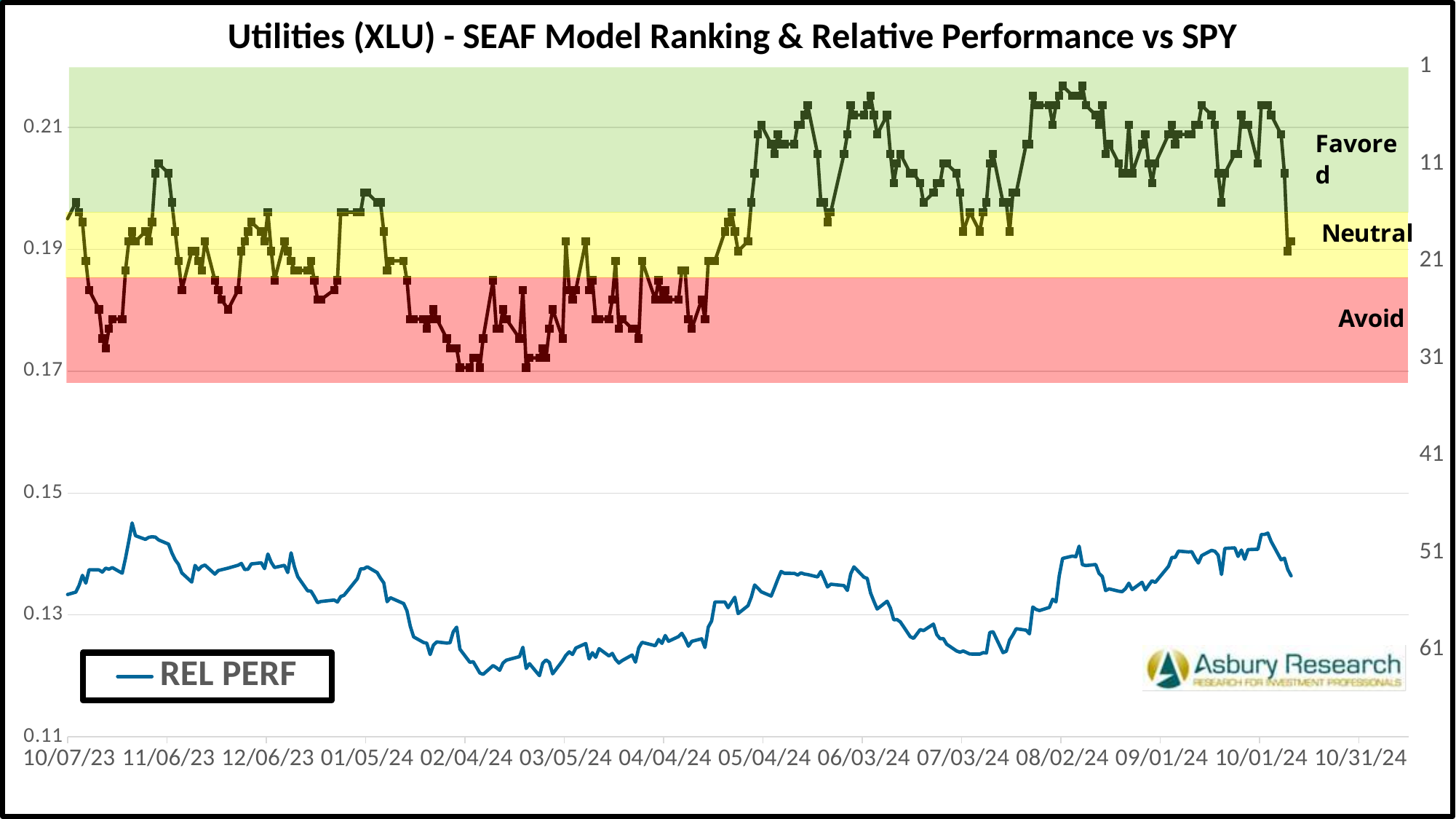
Which is larger, the REL PERF value at 11/06/23 or at 02/04/24? 11/06/23 Does the REL PERF line rise or fall between 10/07/23 and 02/04/24? fall Is the REL PERF value at 11/06/23 greater or less than 0.13? greater Is the lowest REL PERF value on the chart greater or less than 0.13? less What kind of chart is shown on the slide? line chart Is the REL PERF value at 02/04/24 greater or less than 0.13? less What is the title of the chart? Utilities (XLU) - SEAF Model Ranking & Relative Performance vs SPY Does the REL PERF line rise or fall between 02/04/24 and 06/03/24? rise How many date labels are shown along the x axis? 14 What series name appears in the legend? REL PERF How many series does the legend list? 1